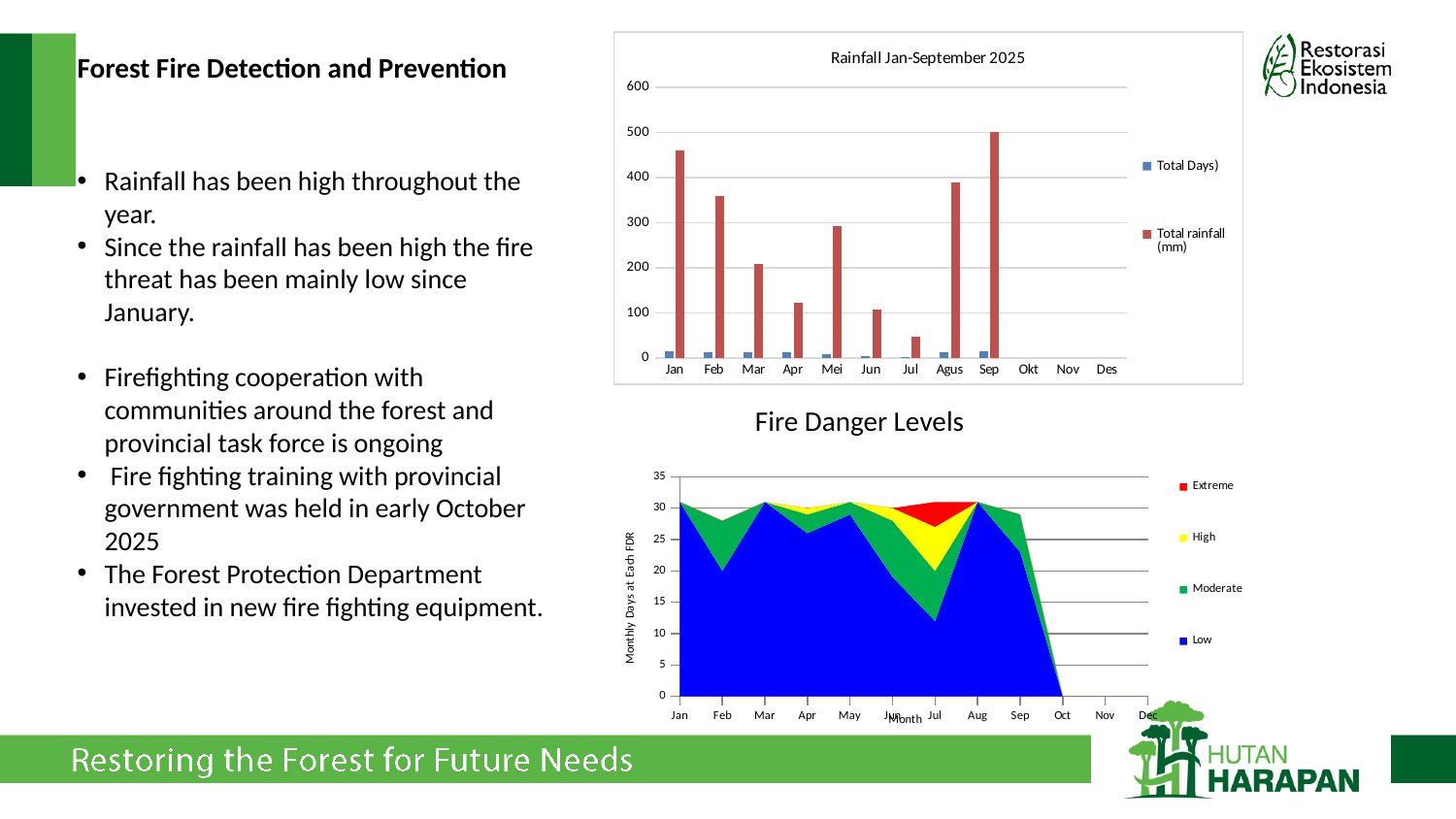
How many series does the legend of the 'Fire Danger Levels' chart list? 4 In the 'Rainfall Jan-September 2025' chart, which month has more total rainfall, Jan or Feb? Jan In the 'Rainfall Jan-September 2025' chart, is the total rainfall for Agus greater or less than 300? greater How many series does the legend of the 'Rainfall Jan-September 2025' chart list? 2 In the 'Fire Danger Levels' chart, which colour represents the 'Low' series? blue What type of chart is the 'Fire Danger Levels' chart? area chart What type of chart is the 'Rainfall Jan-September 2025' chart? bar chart In the 'Rainfall Jan-September 2025' chart, is the total rainfall for Jul greater or less than 100? less In the 'Rainfall Jan-September 2025' chart, is the total rainfall for Jan greater or less than 400? greater How many months are shown on the x axis of the 'Rainfall Jan-September 2025' chart? 12 In the 'Rainfall Jan-September 2025' chart, which month with a rainfall bar has the lowest total rainfall? Jul In the 'Rainfall Jan-September 2025' chart, which month has the highest total rainfall? Sep